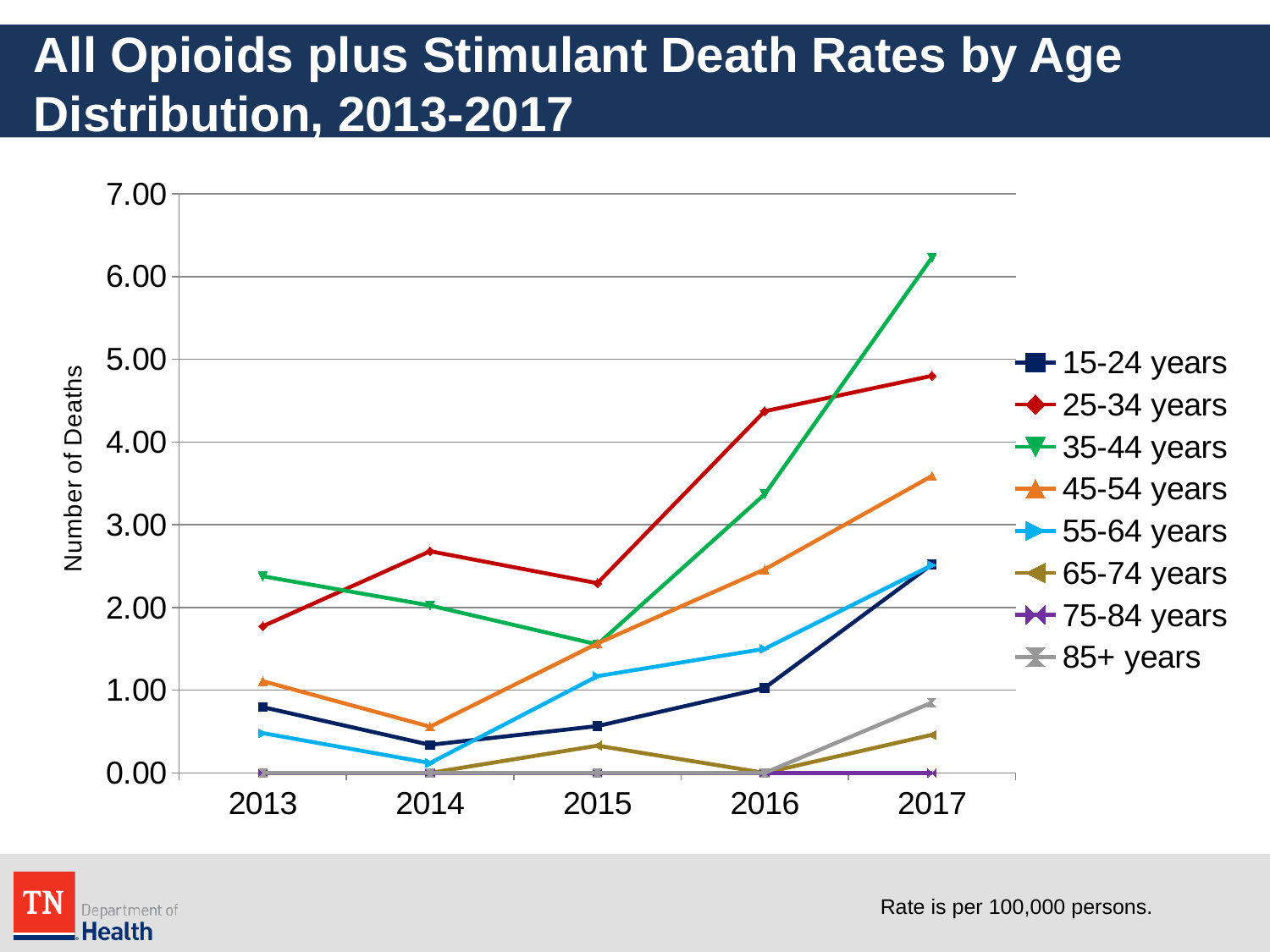
How many age groups does the legend list? 8 What is the label on the y axis? Number of Deaths Does the death rate for 35-44 years rise or fall from 2015 to 2017? Rise Which age group has the highest death rate in 2017? 35-44 years Is the value for 25-34 years in 2016 greater or less than 4.00? greater Is the value for 35-44 years in 2017 greater or less than 6.00? greater Which age group has the highest death rate in 2013? 35-44 years How many years are plotted along the x axis? 5 What kind of chart is shown on the slide? Line chart Which age group has the lowest death rate in 2017? 75-84 years Is the value for 45-54 years in 2017 greater or less than 3.00? greater In 2014, which age group has the larger death rate, 25-34 years or 35-44 years? 25-34 years